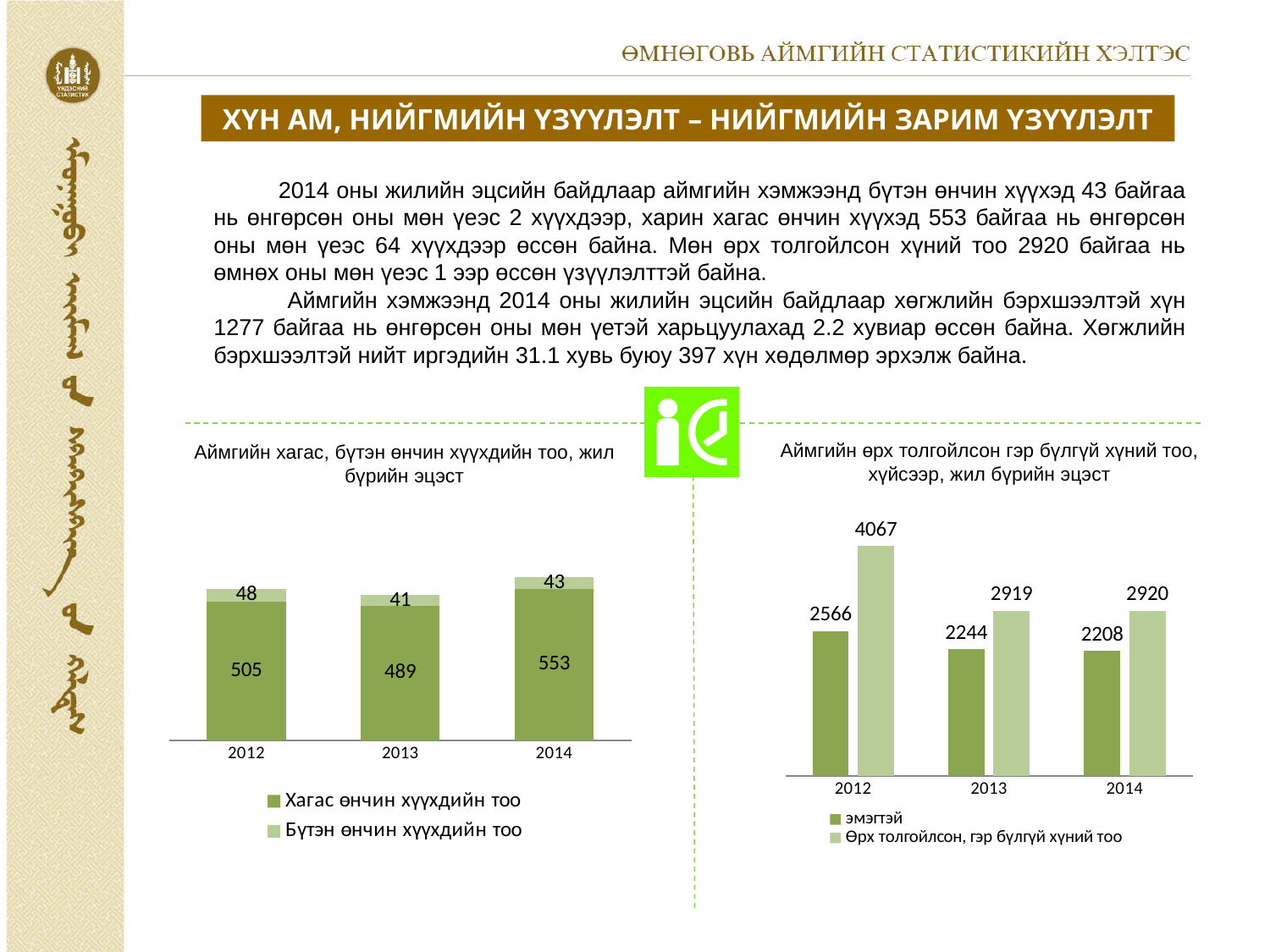
In the right chart (Аймгийн өрх толгойлсон гэр бүлгүй хүний тоо), does the value of эмэгтэй rise or fall from 2012 to 2014? Fall In the right chart (Аймгийн өрх толгойлсон гэр бүлгүй хүний тоо), what is the value of Өрх толгойлсон, гэр бүлгүй хүний тоо for 2012? 4067 In the left chart (Аймгийн хагас, бүтэн өнчин хүүхдийн тоо), what is the difference between Хагас өнчин хүүхдийн тоо in 2014 and 2013? 64 In the left chart (Аймгийн хагас, бүтэн өнчин хүүхдийн тоо), what is the value of Хагас өнчин хүүхдийн тоо for 2014? 553 What kind of chart is the left chart (Аймгийн хагас, бүтэн өнчин хүүхдийн тоо)? Stacked bar chart In the left chart (Аймгийн хагас, бүтэн өнчин хүүхдийн тоо), which year has the lowest value for Хагас өнчин хүүхдийн тоо? 2013 In the left chart (Аймгийн хагас, бүтэн өнчин хүүхдийн тоо), what is the total of the stacked bar for 2012? 553 In the right chart (Аймгийн өрх толгойлсон гэр бүлгүй хүний тоо), which year has the highest value for Өрх толгойлсон, гэр бүлгүй хүний тоо? 2012 In the right chart (Аймгийн өрх толгойлсон гэр бүлгүй хүний тоо), what is the value of эмэгтэй for 2014? 2208 In the left chart (Аймгийн хагас, бүтэн өнчин хүүхдийн тоо), how many series does the legend list? 2 In the right chart (Аймгийн өрх толгойлсон гэр бүлгүй хүний тоо), what is the difference between Өрх толгойлсон, гэр бүлгүй хүний тоо and эмэгтэй in 2013? 675 In the left chart (Аймгийн хагас, бүтэн өнчин хүүхдийн тоо), what is the value of Бүтэн өнчин хүүхдийн тоо for 2013? 41